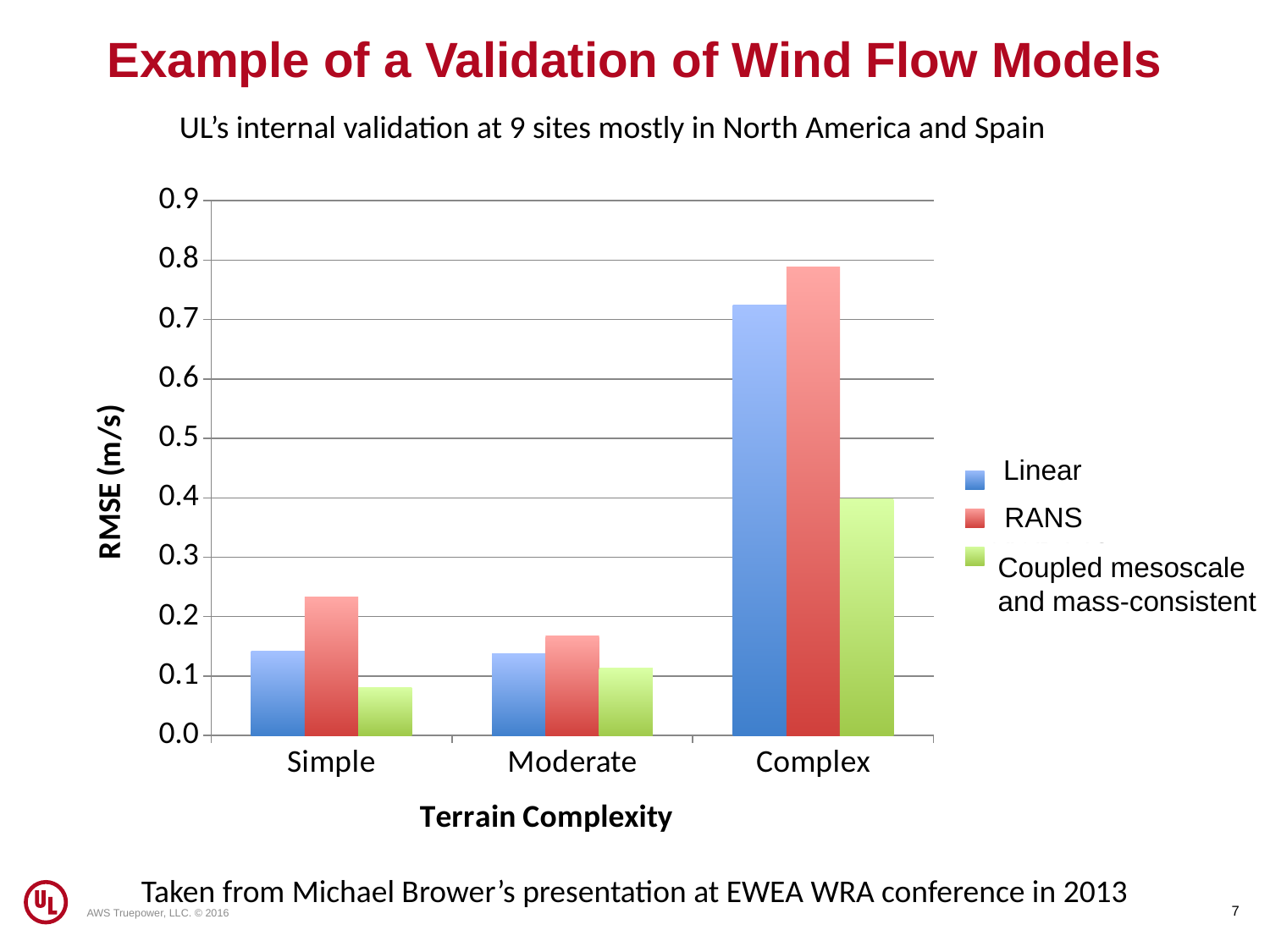
Which series has the highest RMSE in the Simple category? RANS What is the label of the x axis? Terrain Complexity Which is larger: the RMSE for RANS in the Simple category or the RMSE for RANS in the Moderate category? Simple Is the RMSE for Coupled mesoscale and mass-consistent in the Complex category greater or less than 0.5? less Is the RMSE for RANS in the Complex category greater or less than 0.7? greater How many terrain complexity categories are shown on the x axis? 3 What is the label of the y axis? RMSE (m/s) How many series does the legend list? 3 Which terrain complexity category has the highest RMSE for the RANS series? Complex Is the RMSE for Linear in the Simple category greater or less than 0.2? less Which series has the lowest RMSE in the Complex category? Coupled mesoscale and mass-consistent What kind of chart is shown on the slide? bar chart